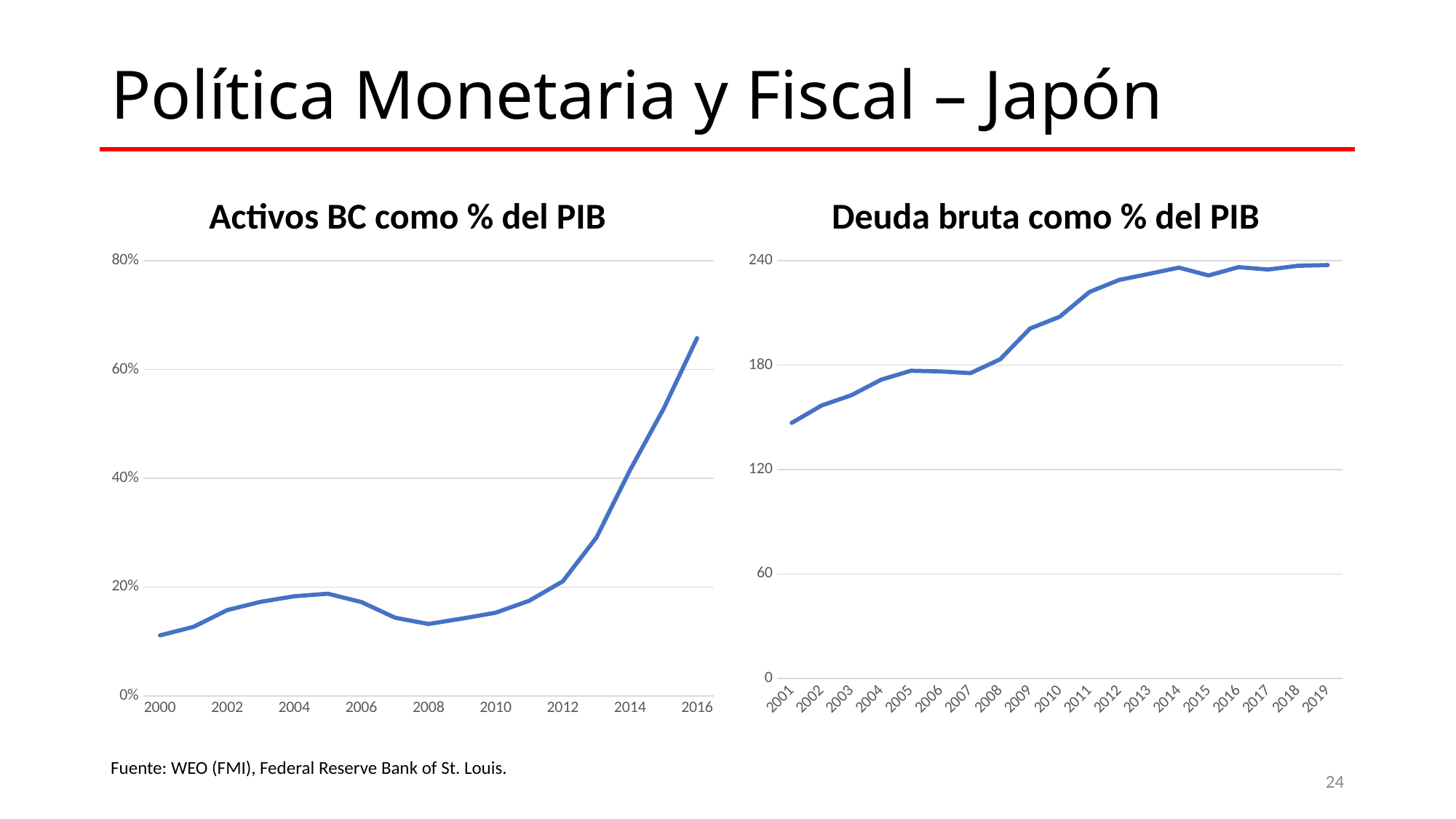
In the 'Activos BC como % del PIB' chart, which year has the lowest value? 2000 What kind of chart is the 'Activos BC como % del PIB' chart? line chart In the 'Deuda bruta como % del PIB' chart, do the values generally rise or fall from 2001 to 2019? rise In the 'Activos BC como % del PIB' chart, is the value for 2016 greater or less than 60%? greater In the 'Deuda bruta como % del PIB' chart, is the value for 2009 greater or less than 180? greater In the 'Activos BC como % del PIB' chart, is the value for 2013 greater or less than 20%? greater In the 'Deuda bruta como % del PIB' chart, which year has the lowest value? 2001 In the 'Activos BC como % del PIB' chart, which year has the highest value? 2016 How many years are shown on the x axis of the 'Deuda bruta como % del PIB' chart? 19 What kind of chart is the 'Deuda bruta como % del PIB' chart? line chart